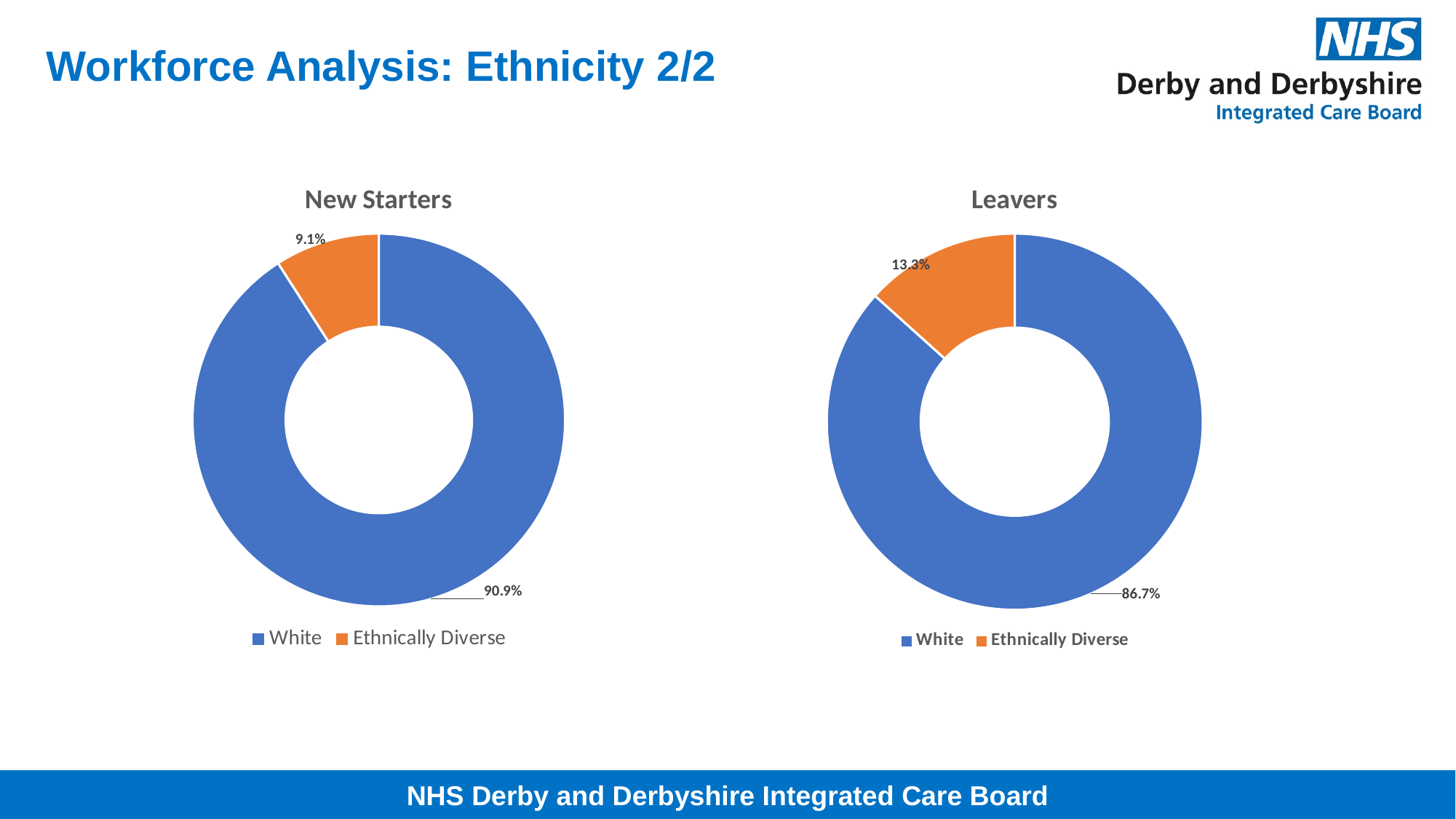
In the New Starters chart, what is the difference between the White and Ethnically Diverse shares? 81.8% In the Leavers chart, what share is White? 86.7% In the New Starters chart, which category has the largest share? White What colour represents Ethnically Diverse in the New Starters chart? Orange How many categories does the Leavers chart show? 2 In the Leavers chart, what is the difference between the White and Ethnically Diverse shares? 73.4% In the Leavers chart, what share is Ethnically Diverse? 13.3% In the New Starters chart, what share is Ethnically Diverse? 9.1% Is the Ethnically Diverse share larger in the New Starters chart or the Leavers chart? Leavers In the New Starters chart, what share is White? 90.9% What kind of chart is the New Starters chart? Doughnut chart In the Leavers chart, which category has the smallest share? Ethnically Diverse